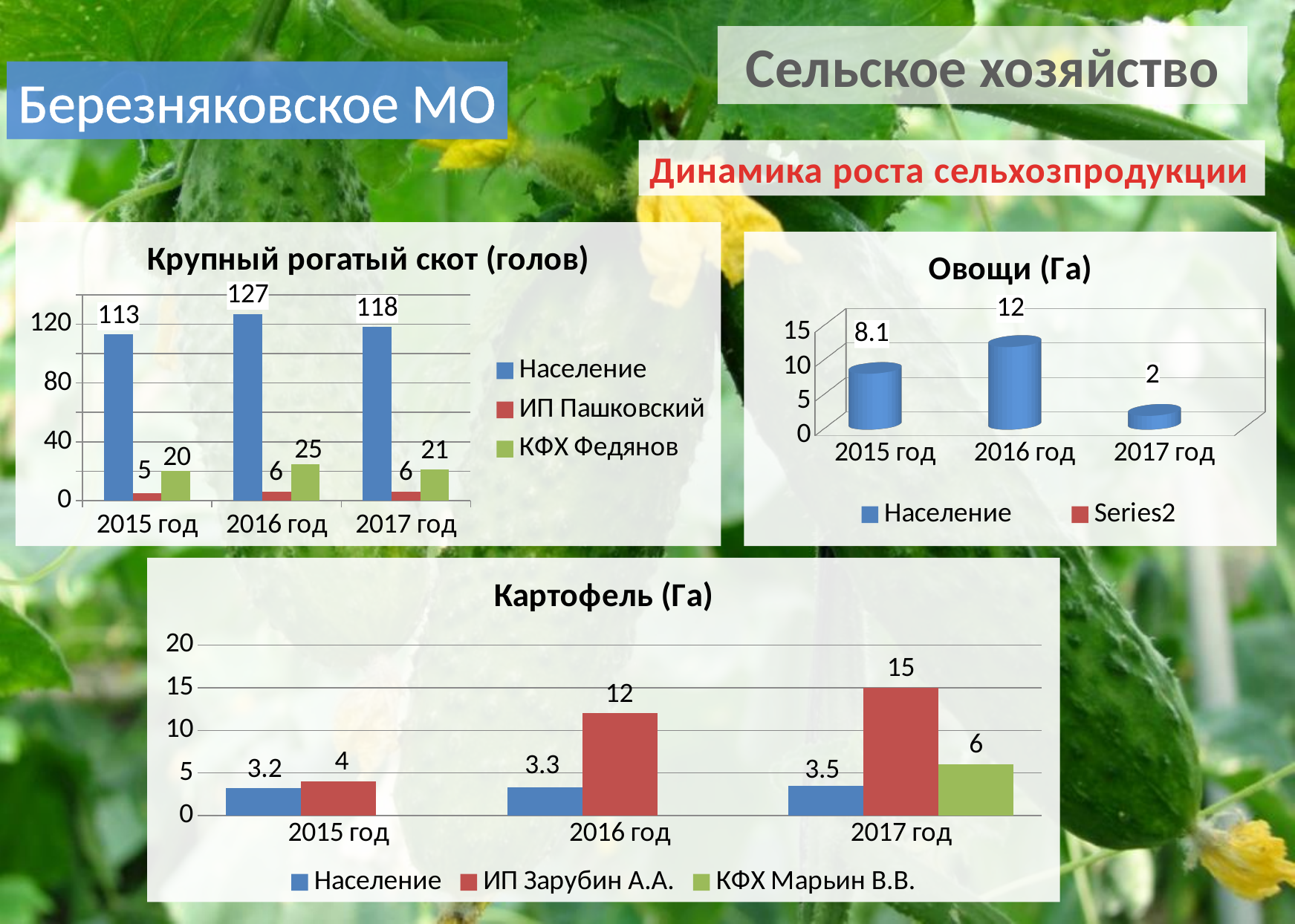
In the chart 'Овощи (Га)', what is the difference between the values for 2016 год and 2017 год? 10 In the chart 'Крупный рогатый скот (голов)', which year has the highest value for Население? 2016 год In the chart 'Овощи (Га)', what is the value for 2015 год? 8.1 In the chart 'Крупный рогатый скот (голов)', what is the value for Население in 2016 год? 127 In the chart 'Крупный рогатый скот (голов)', what is the value for КФХ Федянов in 2017 год? 21 In the chart 'Картофель (Га)', what is the value for ИП Зарубин А.А. in 2017 год? 15 What kind of chart is 'Картофель (Га)'? bar chart In the chart 'Крупный рогатый скот (голов)', what is the difference between the Население values for 2016 год and 2015 год? 14 In the chart 'Картофель (Га)', does the value for Население rise or fall from 2015 год to 2017 год? rise In the chart 'Крупный рогатый скот (голов)', how many series does the legend list? 3 In the chart 'Овощи (Га)', which year has the lowest value? 2017 год In the chart 'Картофель (Га)', which is larger in 2016 год: Население or ИП Зарубин А.А.? ИП Зарубин А.А.